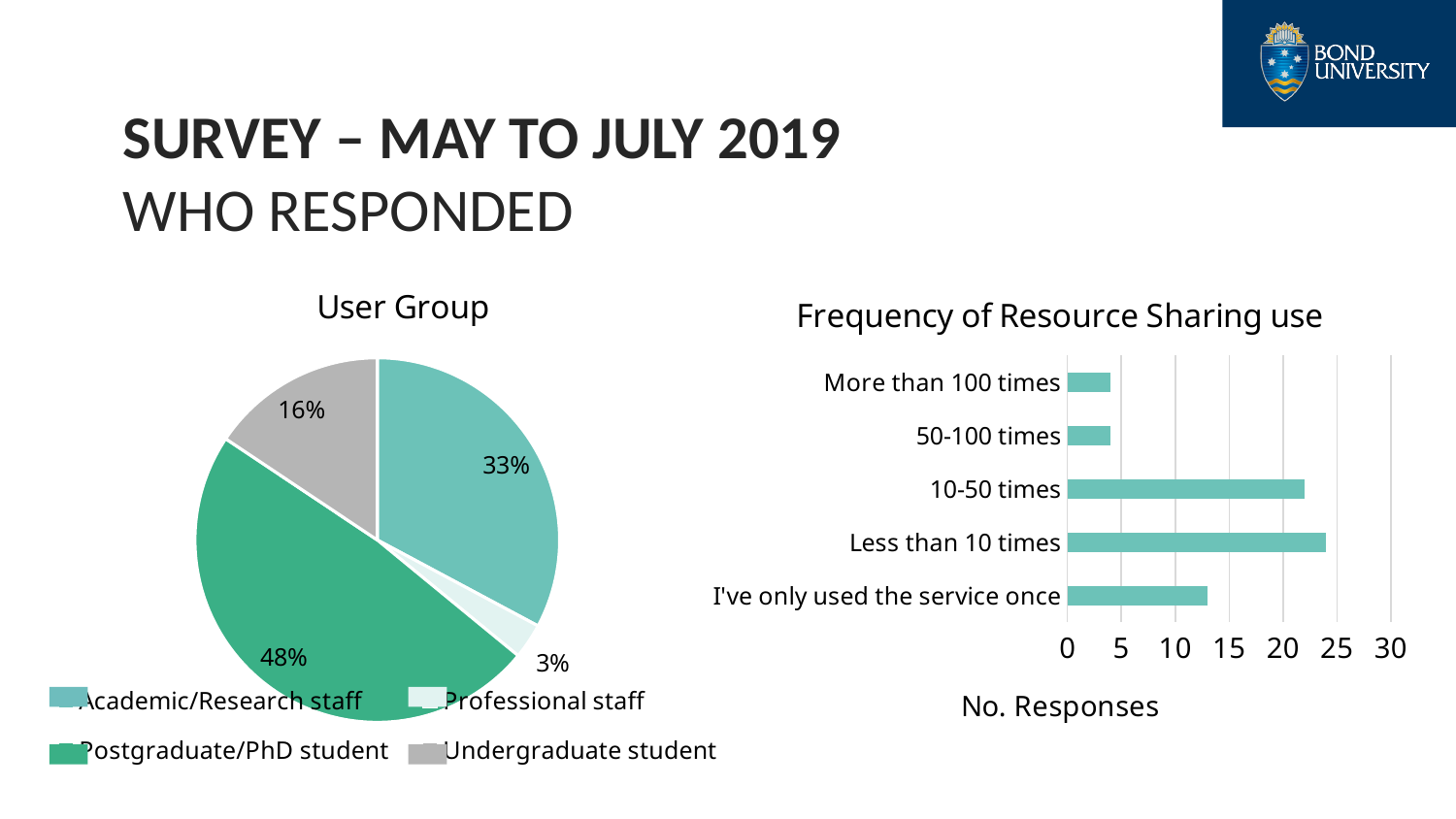
In the Frequency of Resource Sharing use chart, is the number of responses for 'Less than 10 times' greater or less than 20? greater In the Frequency of Resource Sharing use chart, is the number of responses for 'More than 100 times' greater or less than 5? less In the User Group pie chart, what share of respondents were Postgraduate/PhD students? 48% In the User Group pie chart, which user group has the largest share? Postgraduate/PhD student In the Frequency of Resource Sharing use chart, which has more responses: '10-50 times' or 'I've only used the service once'? 10-50 times In the User Group pie chart, what share of respondents were Undergraduate students? 16% In the User Group pie chart, what share of respondents were Academic/Research staff? 33% What kind of chart is the Frequency of Resource Sharing use chart? Bar chart How many user groups does the legend of the User Group pie chart list? 4 How many categories are shown in the Frequency of Resource Sharing use chart? 5 In the User Group pie chart, which user group has the smallest share? Professional staff In the User Group pie chart, what is the difference in percentage points between Postgraduate/PhD students and Academic/Research staff? 15